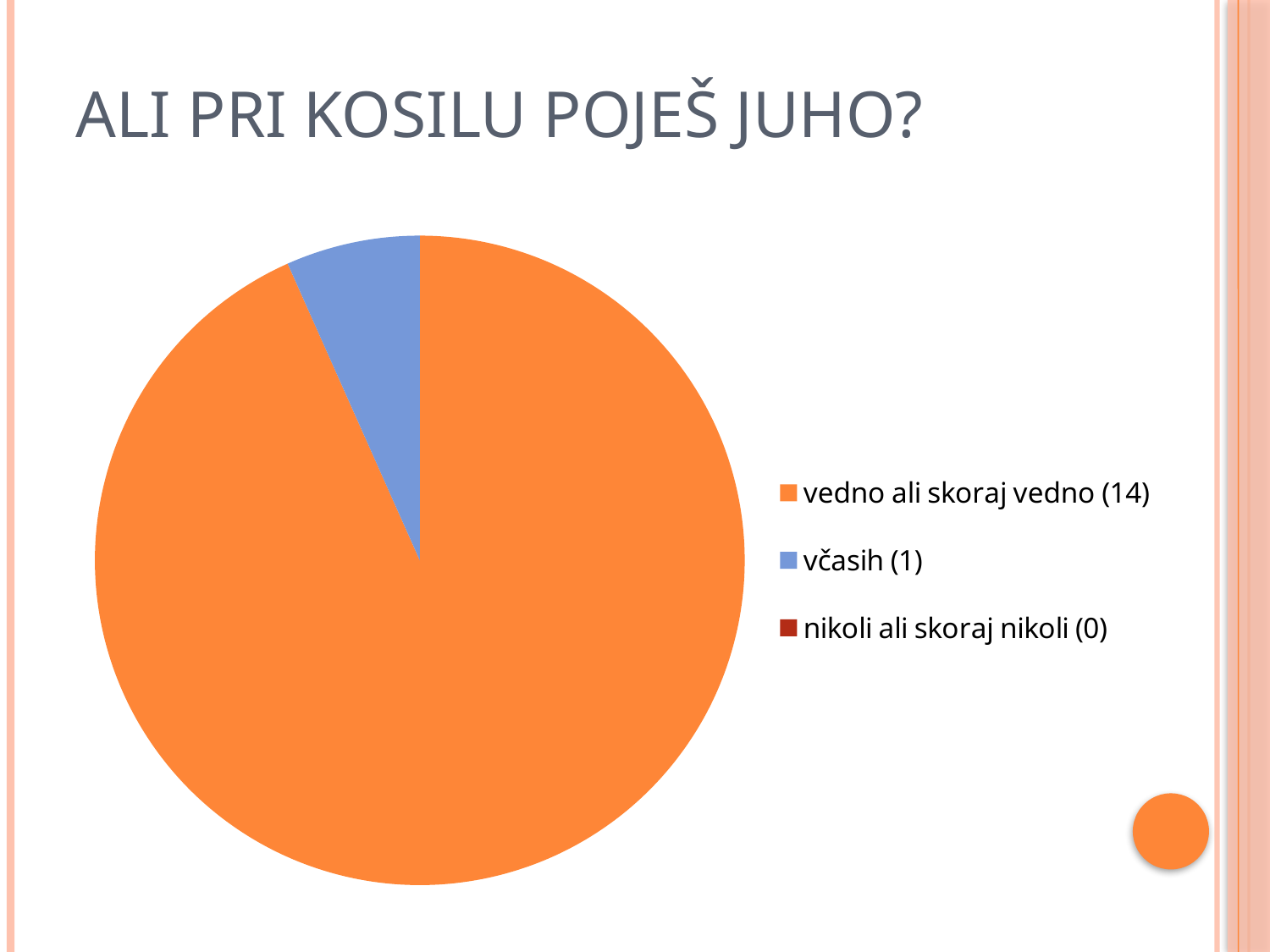
How many categories does the legend list? 3 What colour is the slice for "včasih"? blue What is the difference between the values for "vedno ali skoraj vedno" and "včasih"? 13 What is the value for "nikoli ali skoraj nikoli"? 0 What is the value for "včasih"? 1 What is the value for "vedno ali skoraj vedno"? 14 Which category has the lowest value? nikoli ali skoraj nikoli What is the total of all the values shown in the legend? 15 What is the title of the chart on the slide? ALI PRI KOSILU POJEŠ JUHO? What kind of chart is shown on the slide? pie chart Which category has the highest value? vedno ali skoraj vedno Which is larger, the value for "včasih" or the value for "nikoli ali skoraj nikoli"? včasih